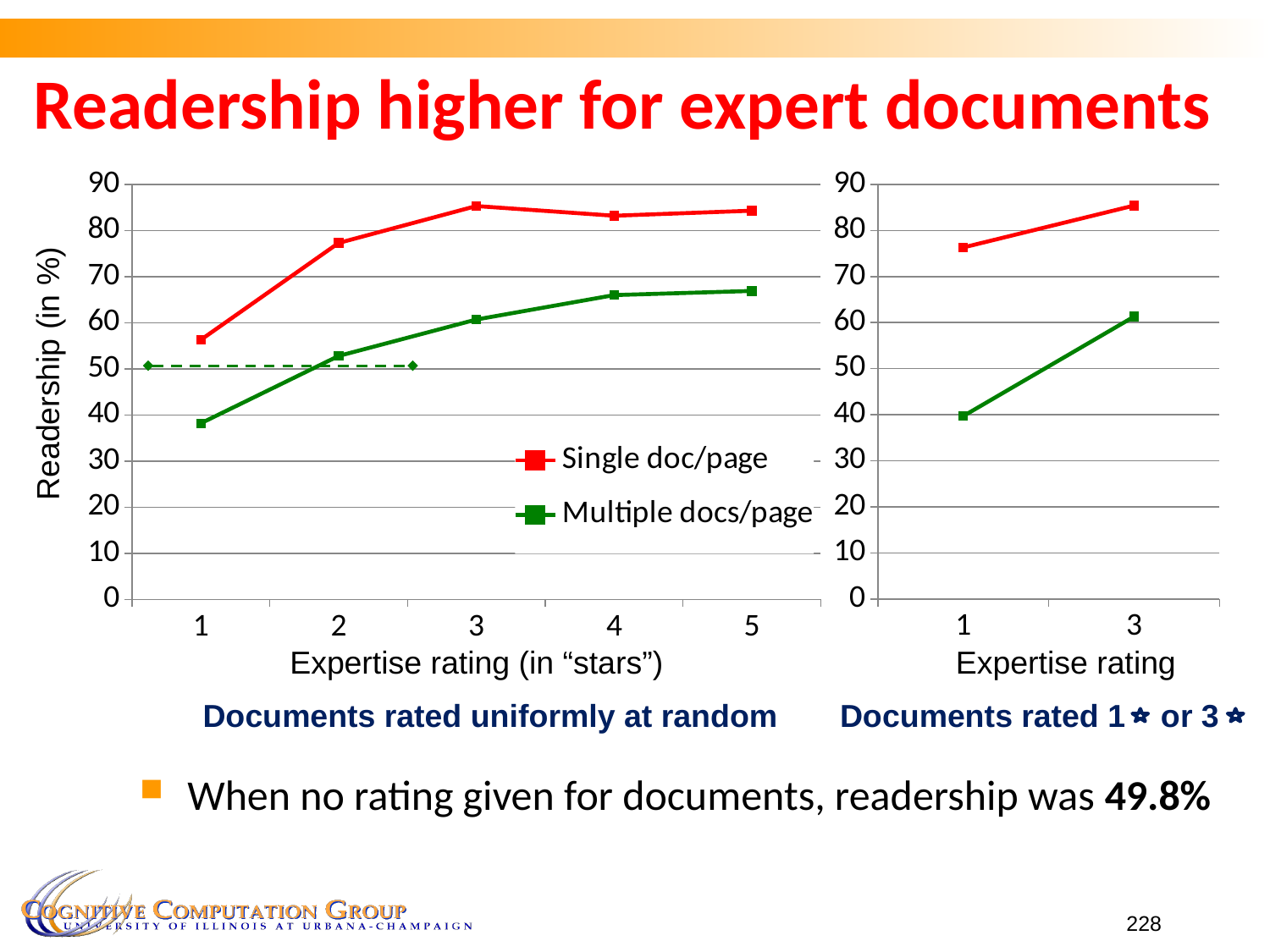
What kind of chart is the left chart, 'Documents rated uniformly at random'? line chart In the left chart, is the Single doc/page value at expertise rating 3 greater or less than 80? greater In the left chart, does the Multiple docs/page readership rise or fall as the expertise rating increases? rise In the left chart, how many expertise rating values are shown on the x axis? 5 In the right chart, 'Documents rated 1 star or 3 star', how many expertise rating values are shown on the x axis? 2 In the left chart, is the Multiple docs/page value at expertise rating 1 greater or less than 50? less In the left chart, at which expertise rating is the Single doc/page readership lowest? 1 In the left chart, which series has the higher readership at expertise rating 2? Single doc/page What is the y-axis label of the left chart? Readership (in %) In the left chart, how many series does the legend list? 2